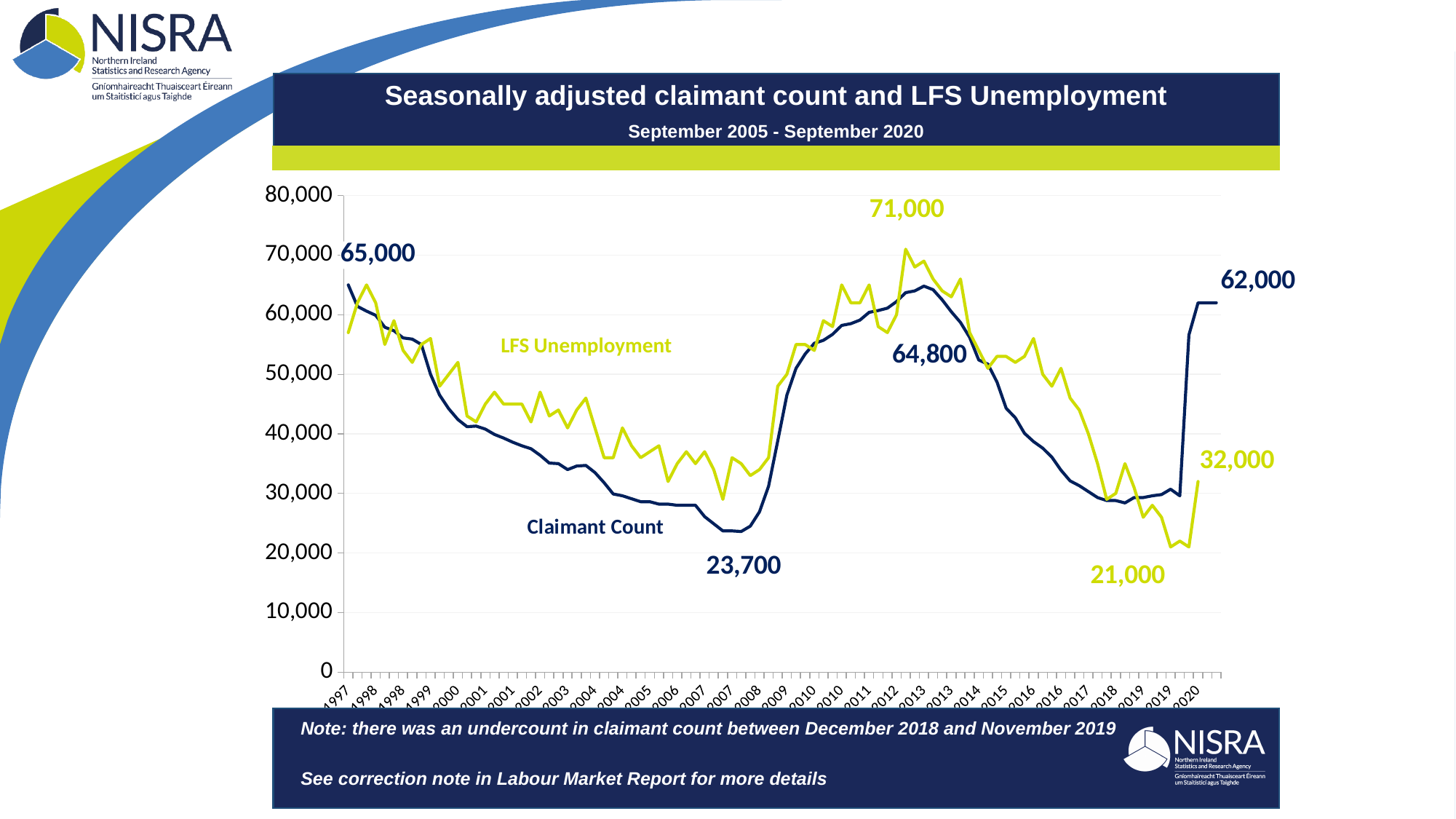
What is the difference between the labelled LFS Unemployment peak of 71,000 and the labelled Claimant Count peak of 64,800? 6,200 What is the labelled lowest value of the Claimant Count series? 23,700 How many series are plotted on the chart? 2 Which series has the higher labelled value at the end of the series in 2020, Claimant Count or LFS Unemployment? Claimant Count What is the difference between the Claimant Count's labelled starting value of 65,000 and its labelled end value of 62,000? 3,000 What is the labelled value of the LFS Unemployment series at the end of the series in 2020? 32,000 What is the labelled lowest value of the LFS Unemployment series? 21,000 What is the title of the chart? Seasonally adjusted claimant count and LFS Unemployment What is the labelled value of the Claimant Count series at the end of the series in 2020? 62,000 What is the labelled value of the Claimant Count series at its 2013 peak? 64,800 What kind of chart is shown on the slide? line chart What is the labelled peak value of the LFS Unemployment series? 71,000